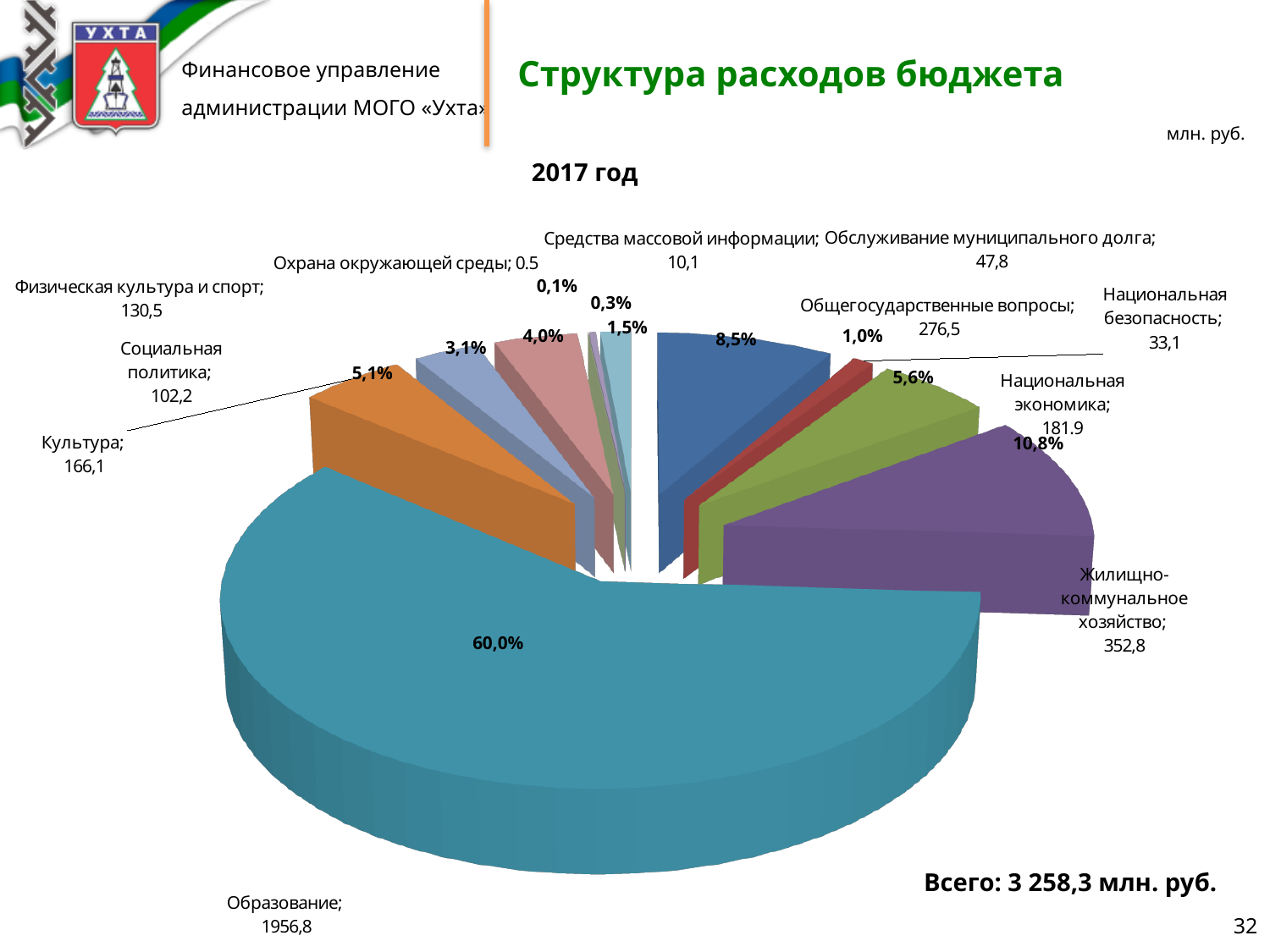
Which is larger, the value for Общегосударственные вопросы or the value for Национальная экономика? Общегосударственные вопросы What kind of chart is shown on the slide? Pie chart What share of the pie does Национальная экономика take? 5,6% What total amount is stated on the slide for the budget expenditures? 3 258,3 млн. руб. What is the value for Национальная безопасность? 33,1 What is the difference between the values for Культура and Социальная политика? 63,9 Which category has the largest slice of the pie? Образование What share of the pie does Образование take? 60,0% How many categories are shown in the pie chart? 11 What is the value for Жилищно-коммунальное хозяйство? 352,8 Which category has the smallest slice of the pie? Охрана окружающей среды What is the value for Образование in the pie chart? 1956,8